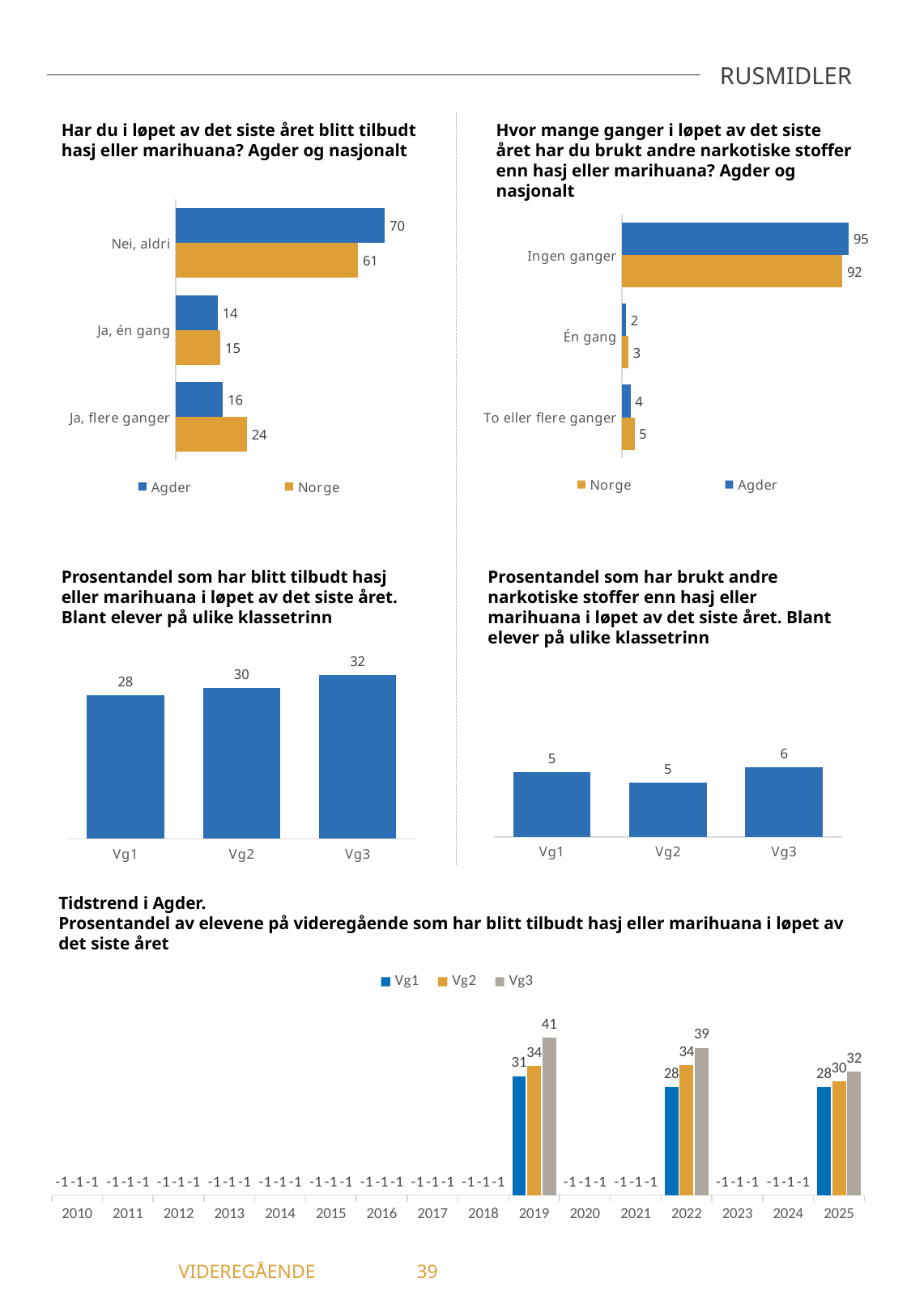
In the top-left chart 'Har du i løpet av det siste året blitt tilbudt hasj eller marihuana?', which is larger for 'Ja, én gang': Agder or Norge? Norge In the top-left chart 'Har du i løpet av det siste året blitt tilbudt hasj eller marihuana?', what is the value for Agder for 'Nei, aldri'? 70 In the top-left chart 'Har du i løpet av det siste året blitt tilbudt hasj eller marihuana?', what is the difference between Norge and Agder for 'Ja, flere ganger'? 8 In the top-right chart 'Hvor mange ganger i løpet av det siste året har du brukt andre narkotiske stoffer enn hasj eller marihuana?', what is the value for Agder for 'To eller flere ganger'? 4 In the middle-left chart 'Prosentandel som har blitt tilbudt hasj eller marihuana i løpet av det siste året', do the values rise or fall from Vg1 to Vg3? rise In the bottom chart 'Tidstrend i Agder', what is the value for Vg3 in 2019? 41 How many series does the legend list in the top-right chart 'Hvor mange ganger i løpet av det siste året har du brukt andre narkotiske stoffer enn hasj eller marihuana?'? 2 In the middle-left chart 'Prosentandel som har blitt tilbudt hasj eller marihuana i løpet av det siste året', which class level has the highest value? Vg3 In the middle-right chart 'Prosentandel som har brukt andre narkotiske stoffer enn hasj eller marihuana i løpet av det siste året', what is the value for Vg3? 6 In the top-right chart 'Hvor mange ganger i løpet av det siste året har du brukt andre narkotiske stoffer enn hasj eller marihuana?', what is the value for Norge for 'Ingen ganger'? 92 What kind of chart is the middle-right chart 'Prosentandel som har brukt andre narkotiske stoffer enn hasj eller marihuana i løpet av det siste året'? bar chart In the bottom chart 'Tidstrend i Agder', what is the difference between Vg3 and Vg1 in 2022? 11